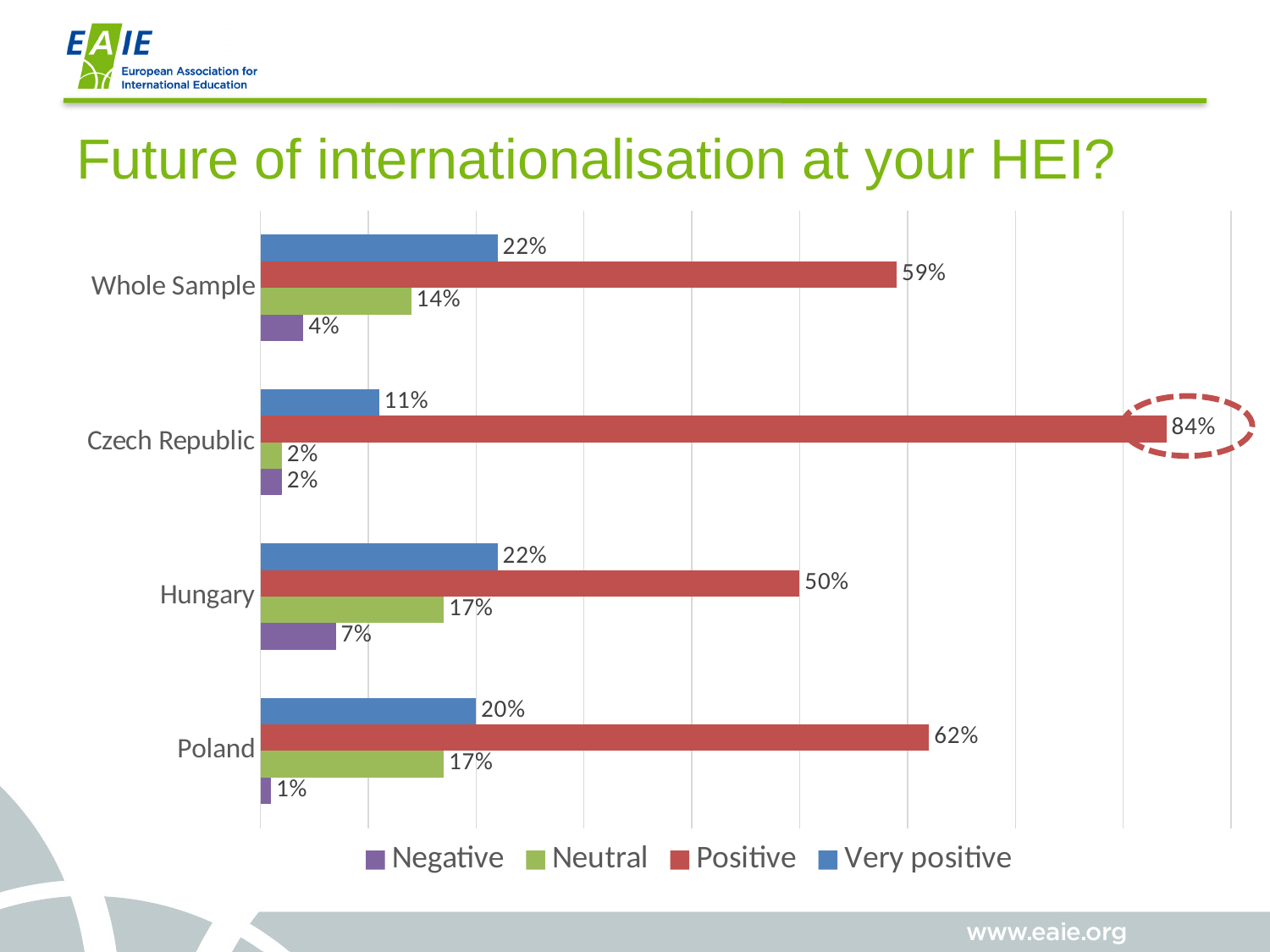
How many series does the legend list? 4 What is the title of the slide? Future of internationalisation at your HEI? How many categories are shown on the chart? 4 What is the Very positive value for Poland? 20% What is the Neutral value for Hungary? 17% Which category has the lowest Negative value? Poland What is the Positive value for Czech Republic? 84% Which is larger, the Positive value for Poland or the Positive value for the Whole Sample? Poland What is the Negative value for the Whole Sample? 4% Which category has the highest Positive value? Czech Republic What kind of chart is shown on the slide? Bar chart What is the difference between the Positive values for Czech Republic and Hungary? 34%